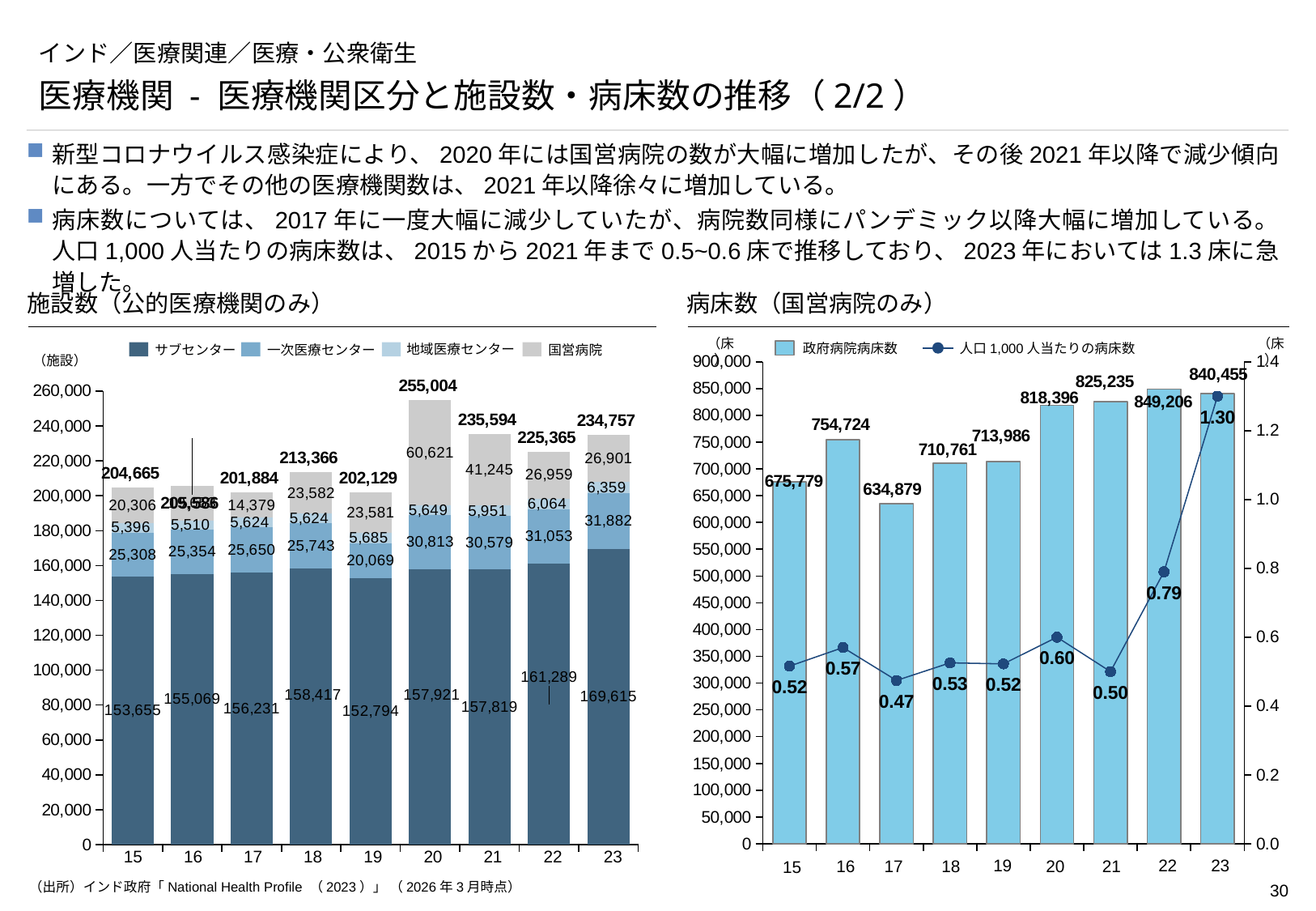
In the left chart (施設数), what is the value for 国営病院 in year 20? 60,621 In the left chart (施設数), how many series does the legend list? 4 In the left chart (施設数), which year has the highest total number of facilities? 20 In the right chart (病床数), which year has the lowest 政府病院病床数? 17 In the right chart (病床数), what is the number of 政府病院病床数 in year 22? 849,206 In the left chart (施設数), what is the difference between the 国営病院 values for year 20 and year 21? 19,376 In the left chart (施設数), what is the total number of facilities shown for year 20? 255,004 In the right chart (病床数), what is the difference between the 政府病院病床数 for year 22 and year 23? 8,751 In the left chart (施設数), what is the value for サブセンター in year 23? 169,615 In the left chart (施設数), how many years are plotted on the x axis? 9 In the right chart (病床数), what is the 人口1,000人当たりの病床数 value for year 23? 1.30 In the right chart (病床数), which year has the larger 政府病院病床数, 16 or 18? 16